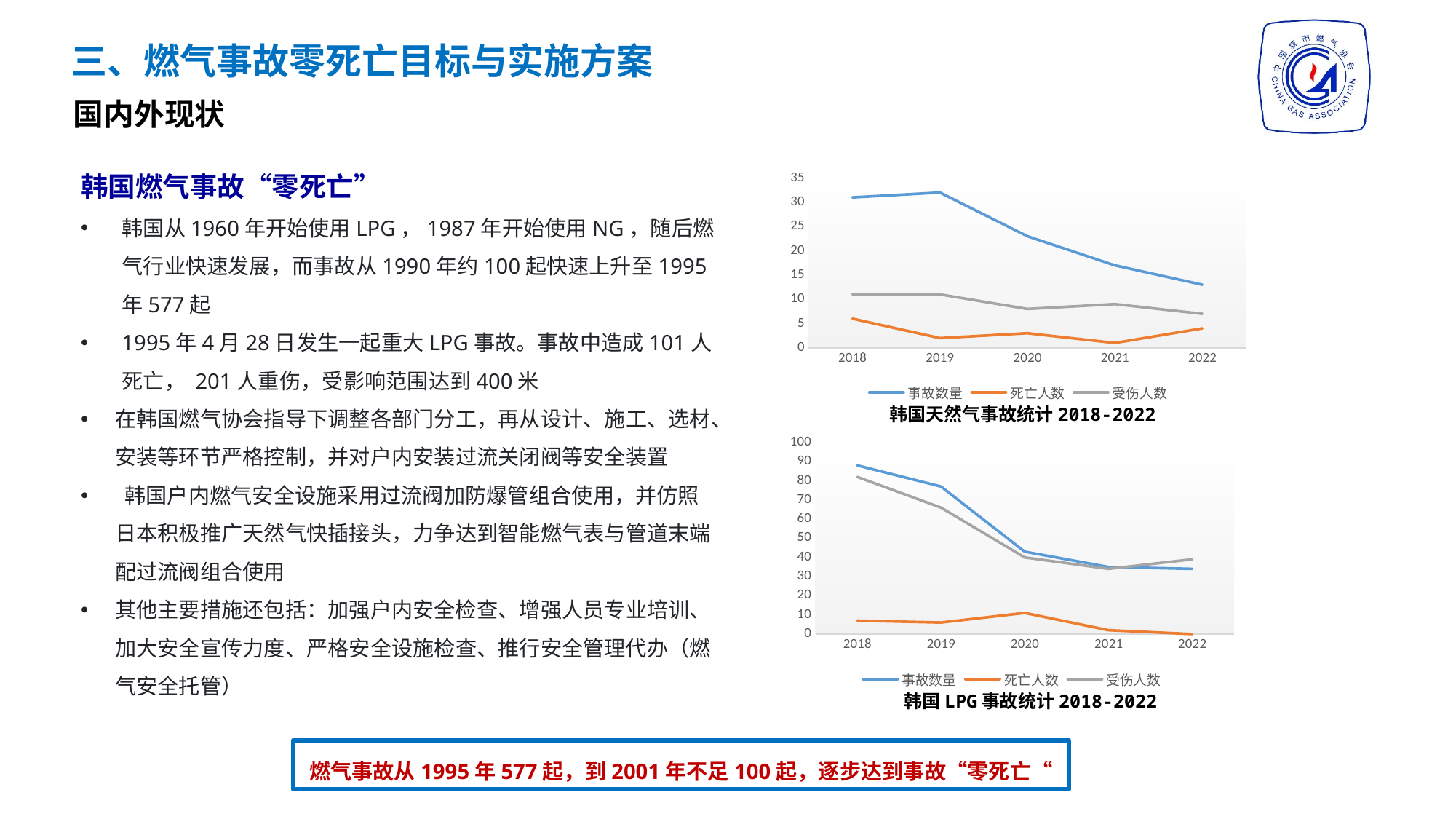
What kind of chart is the top chart titled 韩国天然气事故统计 2018-2022? line chart In the bottom chart (韩国 LPG 事故统计 2018-2022), is the 事故数量 value for 2018 greater or less than 80? greater Which series in the top chart (韩国天然气事故统计 2018-2022) is drawn in orange? 死亡人数 In the bottom chart (韩国 LPG 事故统计 2018-2022), which is larger in 2019: 事故数量 or 受伤人数? 事故数量 In the top chart (韩国天然气事故统计 2018-2022), does the 事故数量 series rise or fall from 2019 to 2022? fall In the top chart (韩国天然气事故统计 2018-2022), which year has the lowest 死亡人数? 2021 In the top chart (韩国天然气事故统计 2018-2022), is the 事故数量 value for 2022 greater or less than 15? less In the bottom chart (韩国 LPG 事故统计 2018-2022), which year has the highest 事故数量? 2018 How many years are shown on the x axis of the top chart (韩国天然气事故统计 2018-2022)? 5 In the bottom chart (韩国 LPG 事故统计 2018-2022), is the 死亡人数 value for 2020 greater or less than 20? less How many series does the legend of the bottom chart (韩国 LPG 事故统计 2018-2022) list? 3